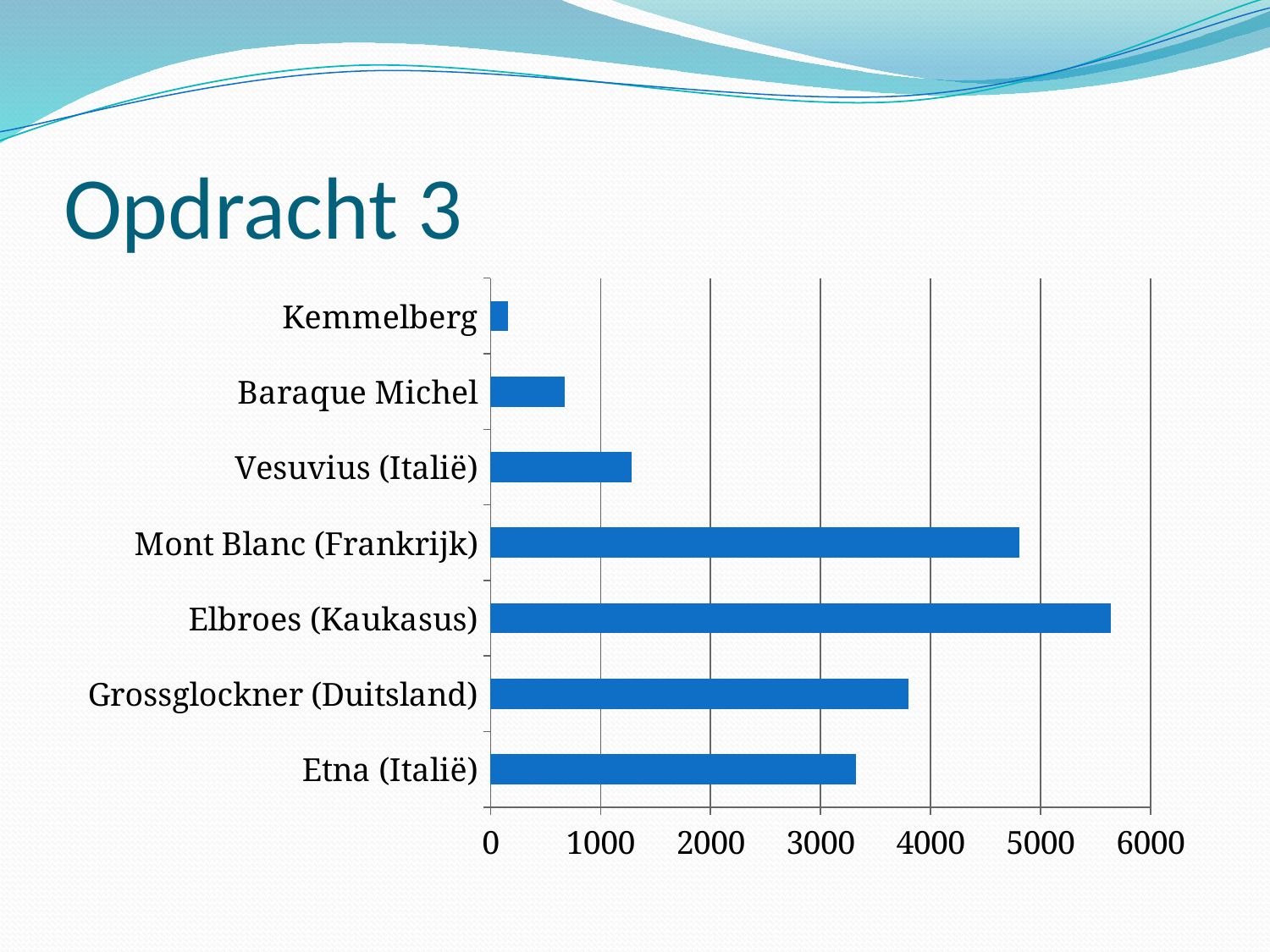
Is the value for Etna (Italië) greater or less than 4000? less Which is larger, the value for Grossglockner (Duitsland) or the value for Etna (Italië)? Grossglockner (Duitsland) Is the value for Mont Blanc (Frankrijk) greater or less than 4000? greater What is the title of the slide containing the chart? Opdracht 3 What kind of chart is shown on the slide? bar chart How many categories (mountains) are shown in the chart? 7 Which category has the highest value in the chart? Elbroes (Kaukasus) Which category has the lowest value in the chart? Kemmelberg Is the value for Baraque Michel greater or less than 1000? less Which is larger, the value for Mont Blanc (Frankrijk) or the value for Elbroes (Kaukasus)? Elbroes (Kaukasus)